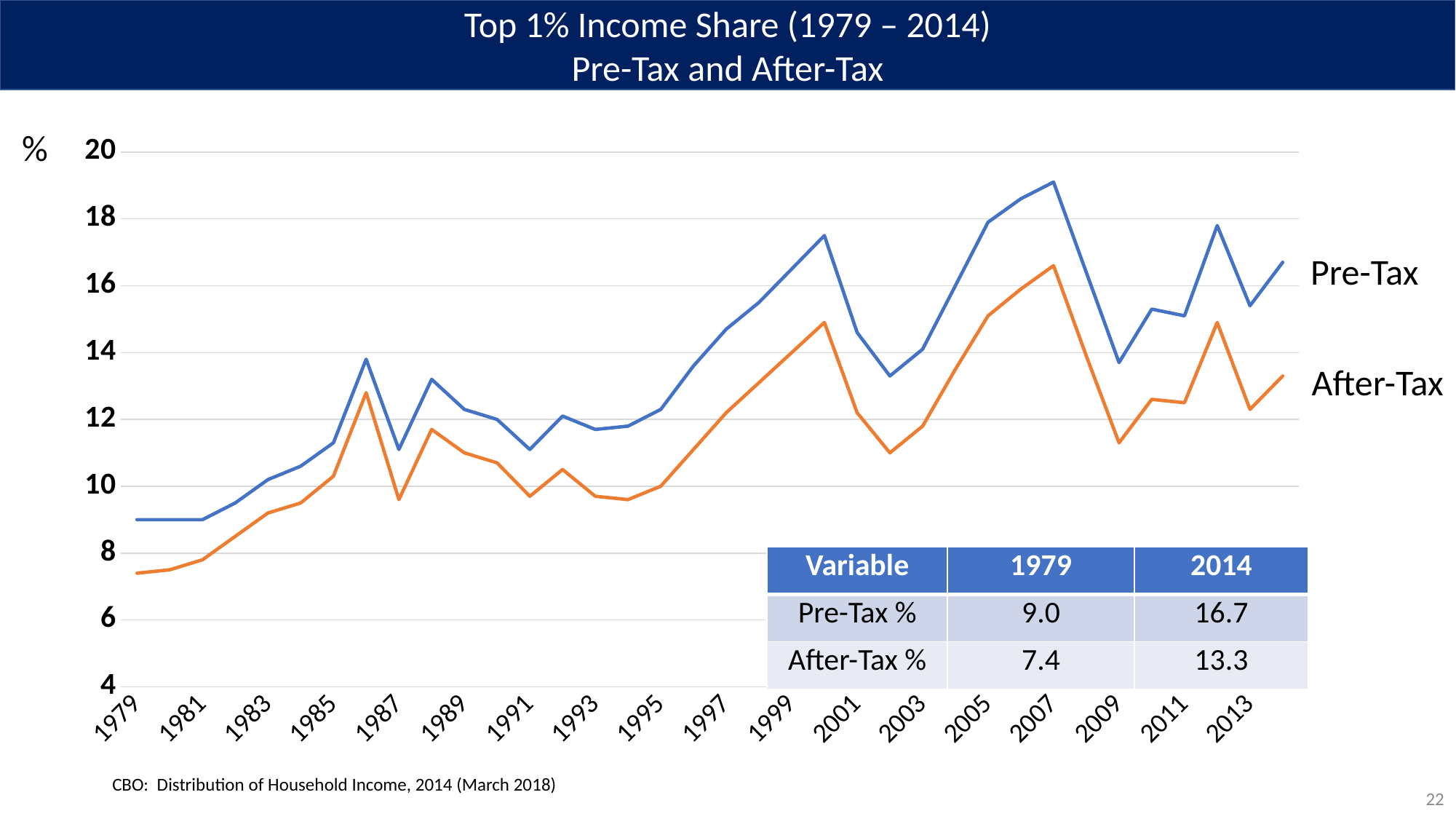
How many series are plotted on the chart? 2 What was the After-Tax top 1% income share in 1979? 7.4 What is the difference between the Pre-Tax and After-Tax shares in 2014? 3.4 What was the Pre-Tax top 1% income share in 1979? 9.0 In which year does the Pre-Tax line reach its highest point? 2007 Which series is higher throughout the period, Pre-Tax or After-Tax? Pre-Tax Overall, do the top 1% income shares rise or fall from 1979 to 2014? rise What type of chart is shown on the slide? line chart What was the Pre-Tax top 1% income share in 2014? 16.7 What was the After-Tax top 1% income share in 2014? 13.3 Is the Pre-Tax value for 2007 greater or less than 18? greater By how much did the Pre-Tax share increase from 1979 to 2014? 7.7